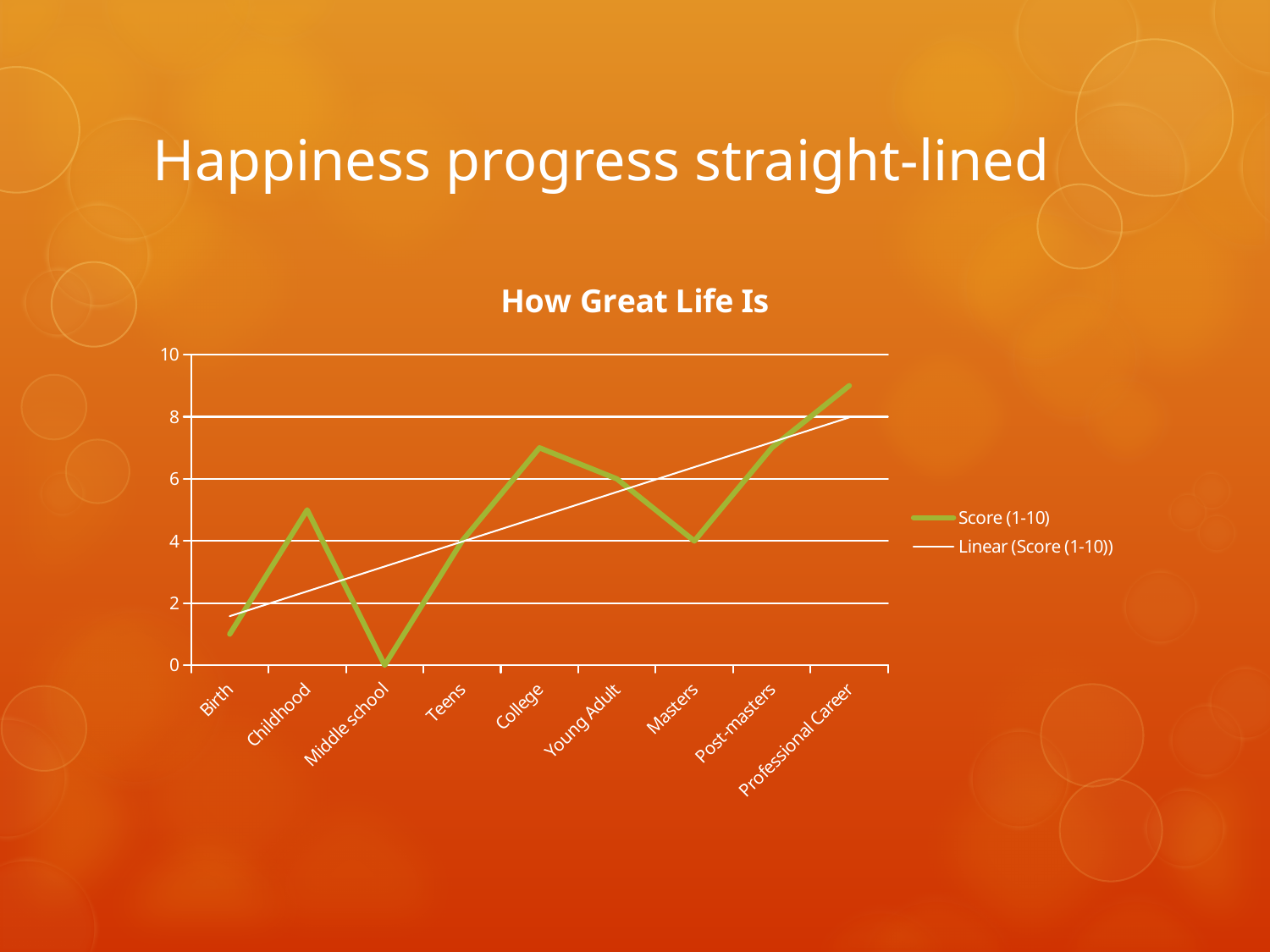
How many series does the legend list? 2 Which category has the lowest score? Middle school What is the score for Middle school? 0 What is the difference between the scores for Young Adult and Masters? 2 Which has a higher score, College or Masters? College What kind of chart is shown on the slide? line chart Is the score for Professional Career greater or less than 8? greater What is the title of the chart? How Great Life Is Is the score for Birth greater or less than 2? less How many categories are shown on the x axis? 9 Which category has the highest score? Professional Career What is the score for Young Adult? 6